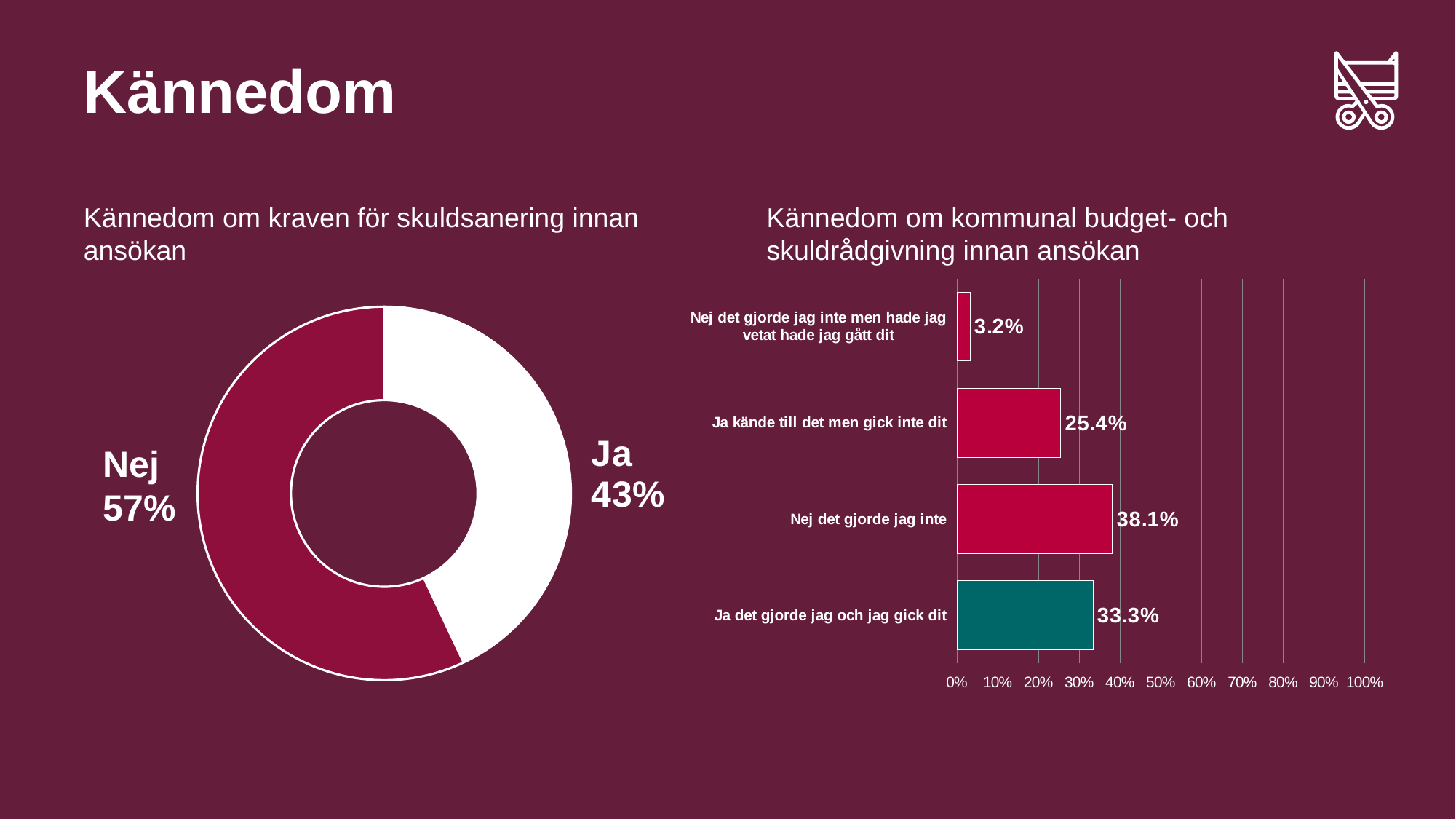
In the right chart (Kännedom om kommunal budget- och skuldrådgivning innan ansökan), what is the difference between 'Nej det gjorde jag inte' and 'Ja det gjorde jag och jag gick dit'? 4.8 percentage points What kind of chart is the right chart (Kännedom om kommunal budget- och skuldrådgivning innan ansökan)? Bar chart How many categories are shown in the right chart (Kännedom om kommunal budget- och skuldrådgivning innan ansökan)? 4 In the left chart (Kännedom om kraven för skuldsanering innan ansökan), what share of respondents answered Ja? 43% In the left chart (Kännedom om kraven för skuldsanering innan ansökan), what share of respondents answered Nej? 57% In the right chart (Kännedom om kommunal budget- och skuldrådgivning innan ansökan), which category has the lowest value? Nej det gjorde jag inte men hade jag vetat hade jag gått dit In the left chart (Kännedom om kraven för skuldsanering innan ansökan), which answer has the larger share, Nej or Ja? Nej In the right chart (Kännedom om kommunal budget- och skuldrådgivning innan ansökan), which category has the highest value? Nej det gjorde jag inte What kind of chart is the left chart (Kännedom om kraven för skuldsanering innan ansökan)? Doughnut (pie) chart In the right chart (Kännedom om kommunal budget- och skuldrådgivning innan ansökan), what is the value for 'Ja det gjorde jag och jag gick dit'? 33.3% In the right chart (Kännedom om kommunal budget- och skuldrådgivning innan ansökan), what is the value for 'Ja kände till det men gick inte dit'? 25.4% In the left chart (Kännedom om kraven för skuldsanering innan ansökan), what is the difference in percentage points between Nej and Ja? 14 percentage points